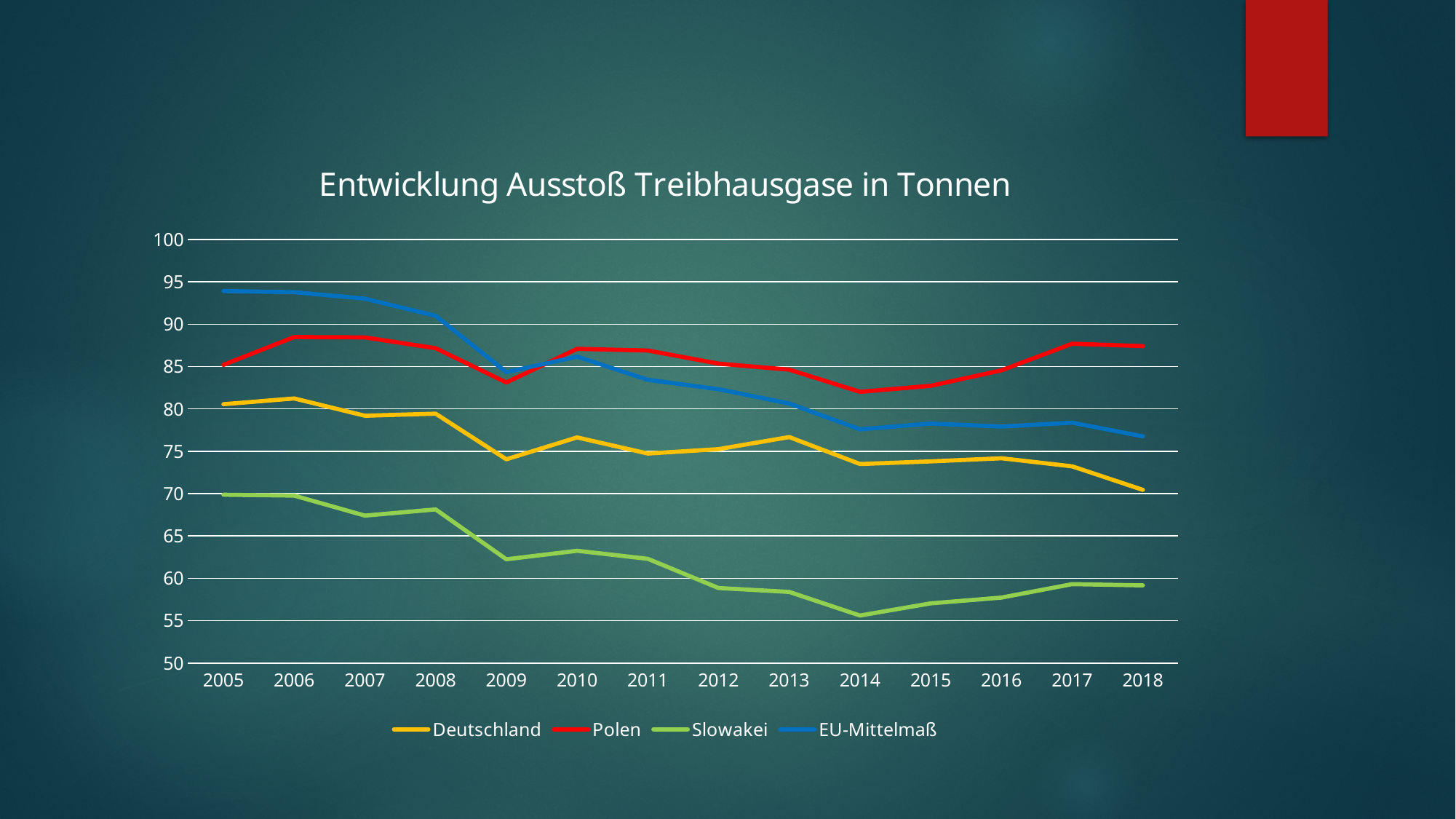
Which series has the lowest value in 2018? Slowakei Which is larger in 2014, the value for Polen or the value for EU-Mittelmaß? Polen Is the value for Slowakei in 2014 greater or less than 60? less Is the value for Deutschland in 2018 greater or less than 75? less Does the value for Slowakei rise or fall from 2005 to 2014? fall How many years are shown on the x axis? 14 Is the value for EU-Mittelmaß in 2005 greater or less than 90? greater Which is larger in 2018, the value for Polen or the value for Deutschland? Polen What kind of chart is shown on the slide? line chart What is the title of the chart? Entwicklung Ausstoß Treibhausgase in Tonnen How many series does the legend list? 4 Which series has the highest value in 2005? EU-Mittelmaß